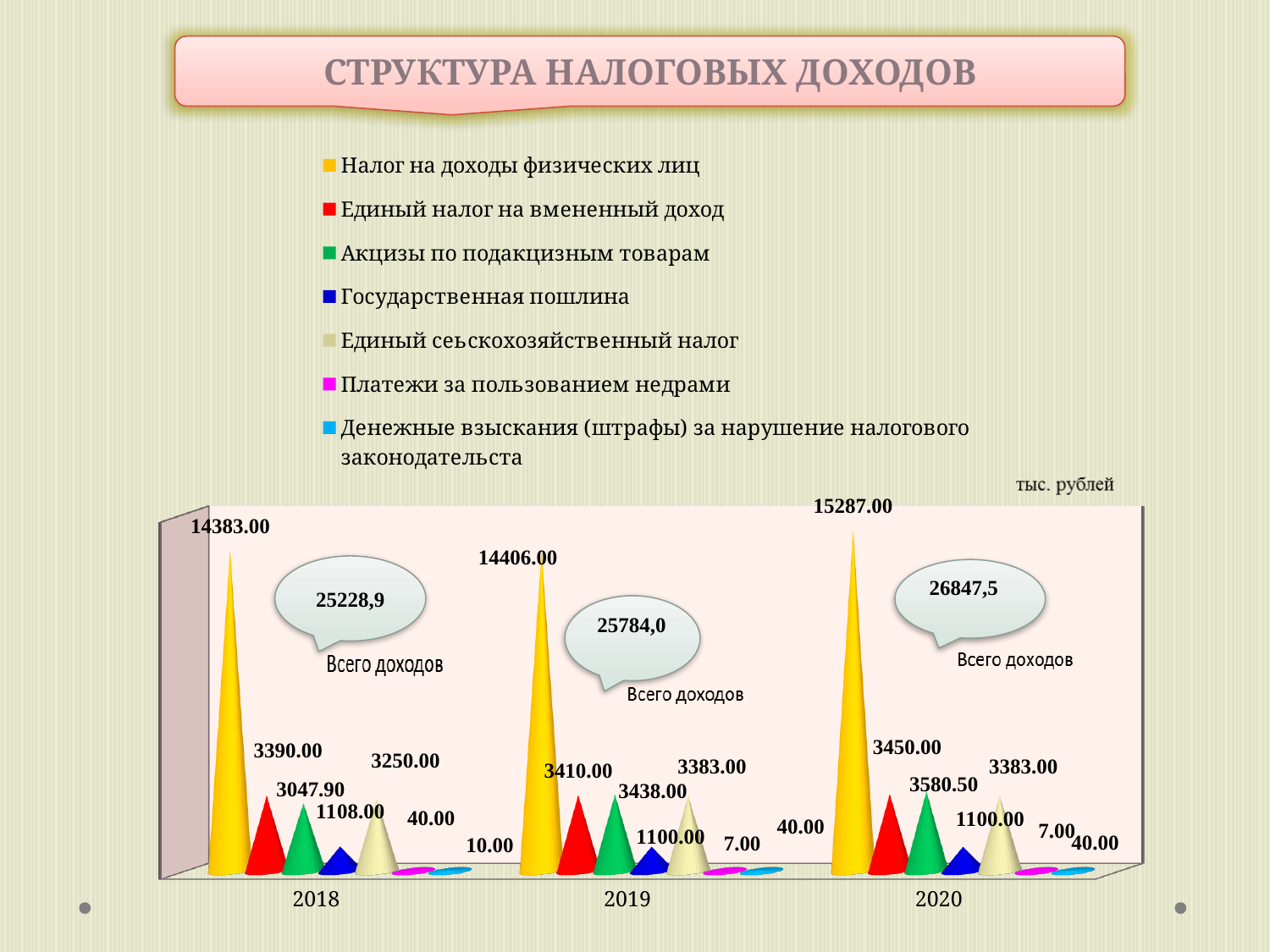
What total income (Всего доходов) is shown in the callout for 2020? 26847,5 What is the value for Акцизы по подакцизным товарам in 2018? 3047.90 How many years are shown on the x axis of the chart? 3 What is the value for Единый налог на вмененный доход in 2019? 3410.00 What kind of chart is shown on the slide? bar chart What is the difference between the Налог на доходы физических лиц values for 2020 and 2018? 904.00 Does the value for Налог на доходы физических лиц rise or fall from 2018 to 2020? rise What is the value for Государственная пошлина in 2019? 1100.00 In which year is Налог на доходы физических лиц the highest? 2020 What is the value for Налог на доходы физических лиц in 2020? 15287.00 In 2020, which is larger: Единый налог на вмененный доход or Акцизы по подакцизным товарам? Акцизы по подакцизным товарам How many series does the legend list? 7